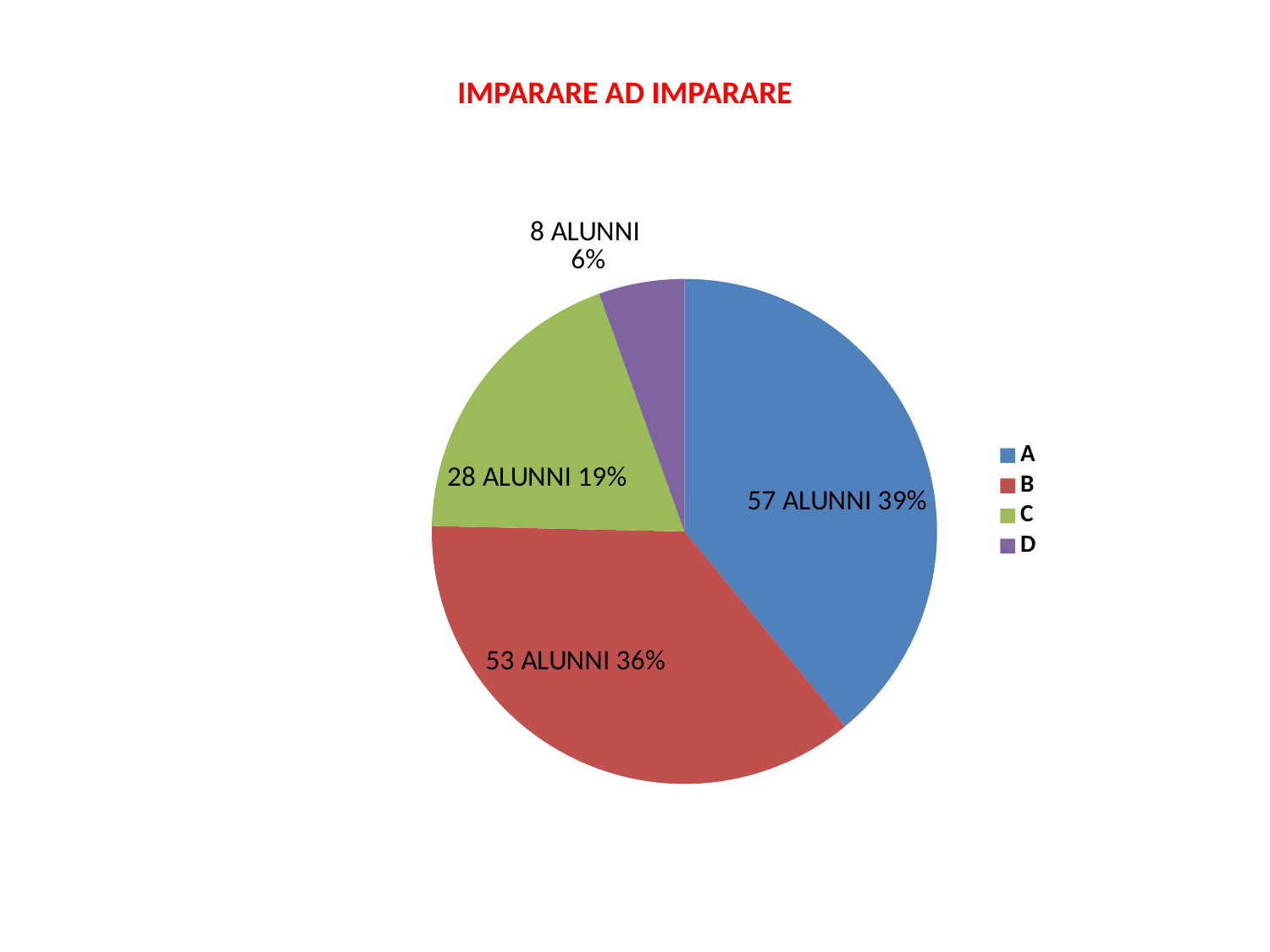
How many alunni are in category C? 28 ALUNNI Which category has the smallest slice? D What percentage share does category D have? 6% Which category has more alunni, C or D? C How many entries does the legend list? 4 What kind of chart is shown on the slide? pie chart Which category has the largest slice? A What is the title of the chart? IMPARARE AD IMPARARE What percentage share does category B have? 36% How many alunni are in category A? 57 ALUNNI What is the difference in number of alunni between category A and category B? 4 How many slices does the pie chart have? 4